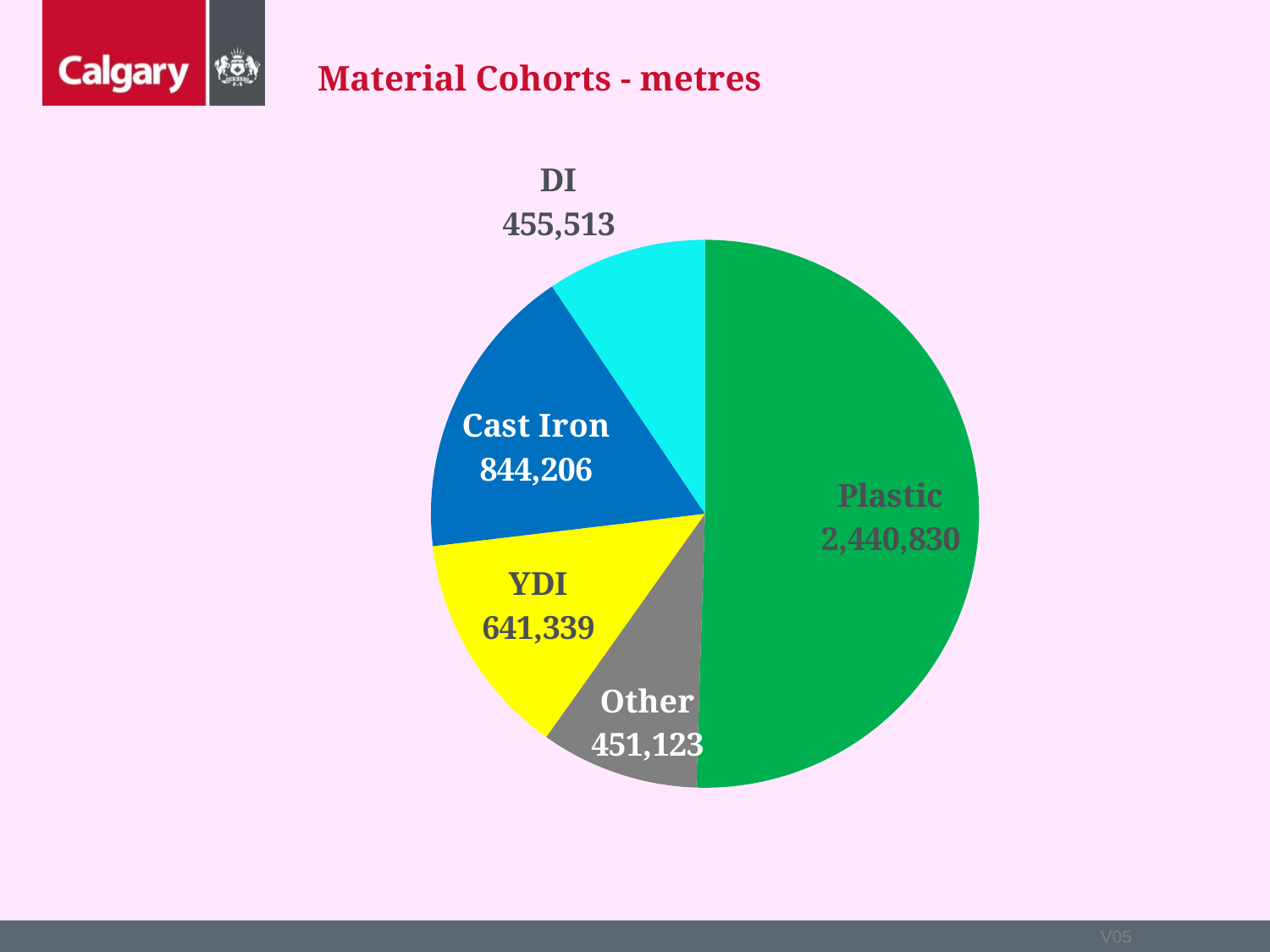
What is the value for Plastic? 2,440,830 What is the difference between the Cast Iron and YDI values? 202,867 What is the value for YDI? 641,339 What is the title of the chart? Material Cohorts - metres Which is larger, Cast Iron or YDI? Cast Iron Which material has the smallest value? Other Which material has the largest slice of the pie? Plastic What is the difference between the Plastic and Cast Iron values? 1,596,624 What is the value for DI? 455,513 What is the value for Cast Iron? 844,206 What kind of chart is shown on the slide? Pie chart How many slices does the pie chart have? 5